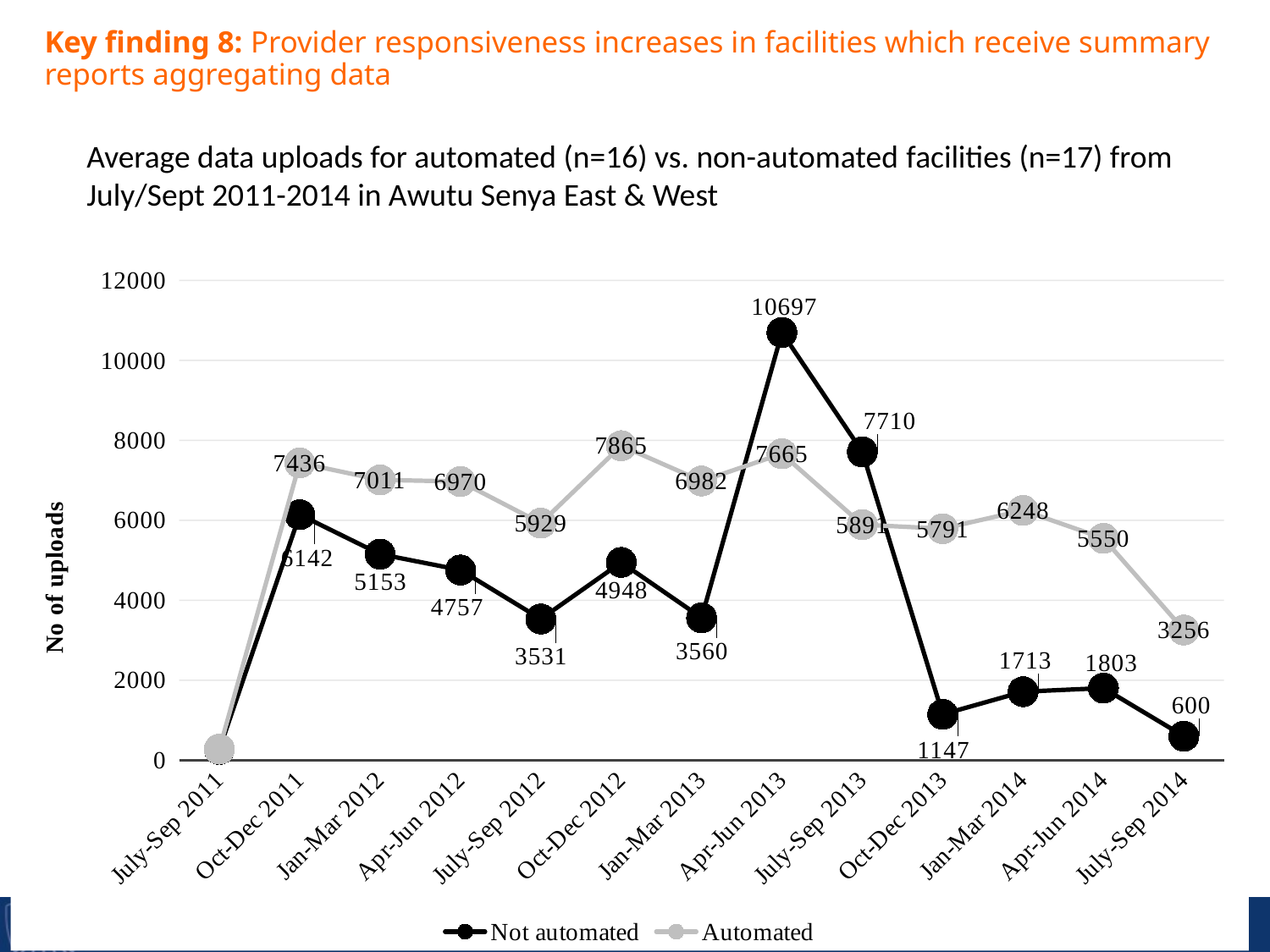
What is the value for Not automated in Oct-Dec 2013? 1147 What is the value for Not automated in Apr-Jun 2013? 10697 What is the value for Automated in Oct-Dec 2012? 7865 How many time periods are shown on the x axis? 13 What kind of chart is shown on the slide? Line chart What is the difference between Not automated and Automated in Apr-Jun 2013? 3032 What is the label on the y axis? No of uploads In which period does the Automated series reach its highest value? Oct-Dec 2012 In which period does the Not automated series reach its highest value? Apr-Jun 2013 Which series has the larger value in Jan-Mar 2014? Automated How many series does the legend list? 2 Is the value for Not automated in Apr-Jun 2013 greater or less than 10000? greater